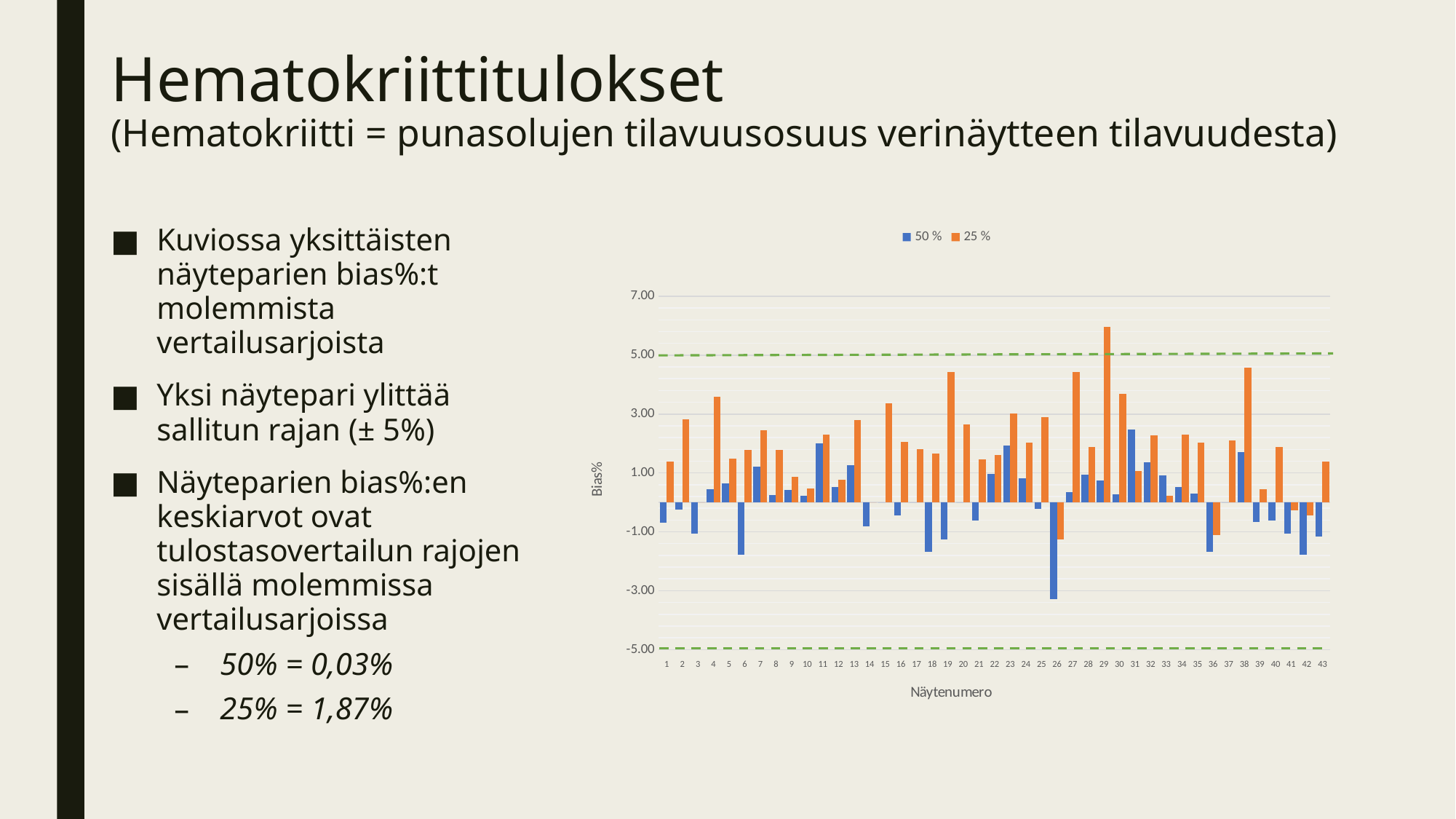
For sample 19, which series has the larger value, 50 % or 25 %? 25 % What is the title of the chart's y axis? Bias% How many series does the chart legend list? 2 Is the 25 % value for sample 38 greater or less than 3.00? greater Is the 50 % value for sample 26 greater or less than -3.00? less Which sample number has the lowest value in the 50 % series? 26 Which sample number has the highest value in the 25 % series? 29 How many sample numbers (Näytenumero) are plotted along the x axis? 43 Is the 50 % value for sample 31 greater or less than 1.00? greater What kind of chart is shown on the slide? bar chart What are the two series names shown in the chart legend? 50 % and 25 %